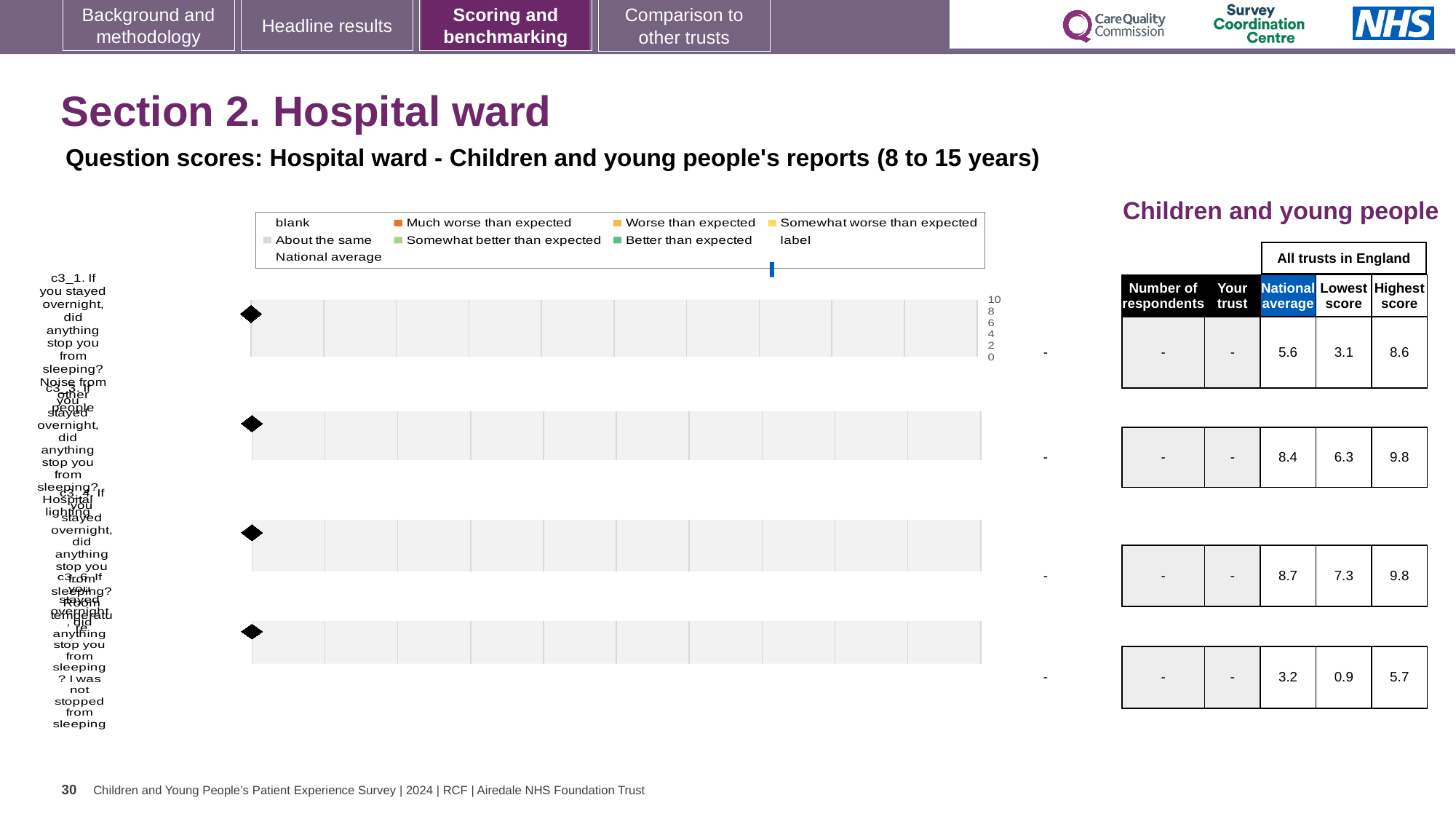
Which legend entry is shown with an orange marker? Much worse than expected In the table to the right of the chart, which row has the highest National average? the third row (8.7) In the table to the right of the chart, what is the Highest score for the second row? 9.8 How many bars (question rows) does the chart contain? 4 In the table to the right of the chart, which row has the lowest National average? the fourth row (3.2) In the table to the right of the chart, is the National average for the second row (8.4) larger or smaller than that for the third row (8.7)? smaller What kind of chart is shown on the slide? bar chart In the table to the right of the chart, what is the difference between the Highest score and Lowest score in the first row? 5.5 What is the highest value shown on the chart's axis? 10 In the table to the right of the chart, what is the Lowest score for the fourth row? 0.9 In the table to the right of the chart, what is the National average for the first row? 5.6 How many entries does the chart's legend list? 9